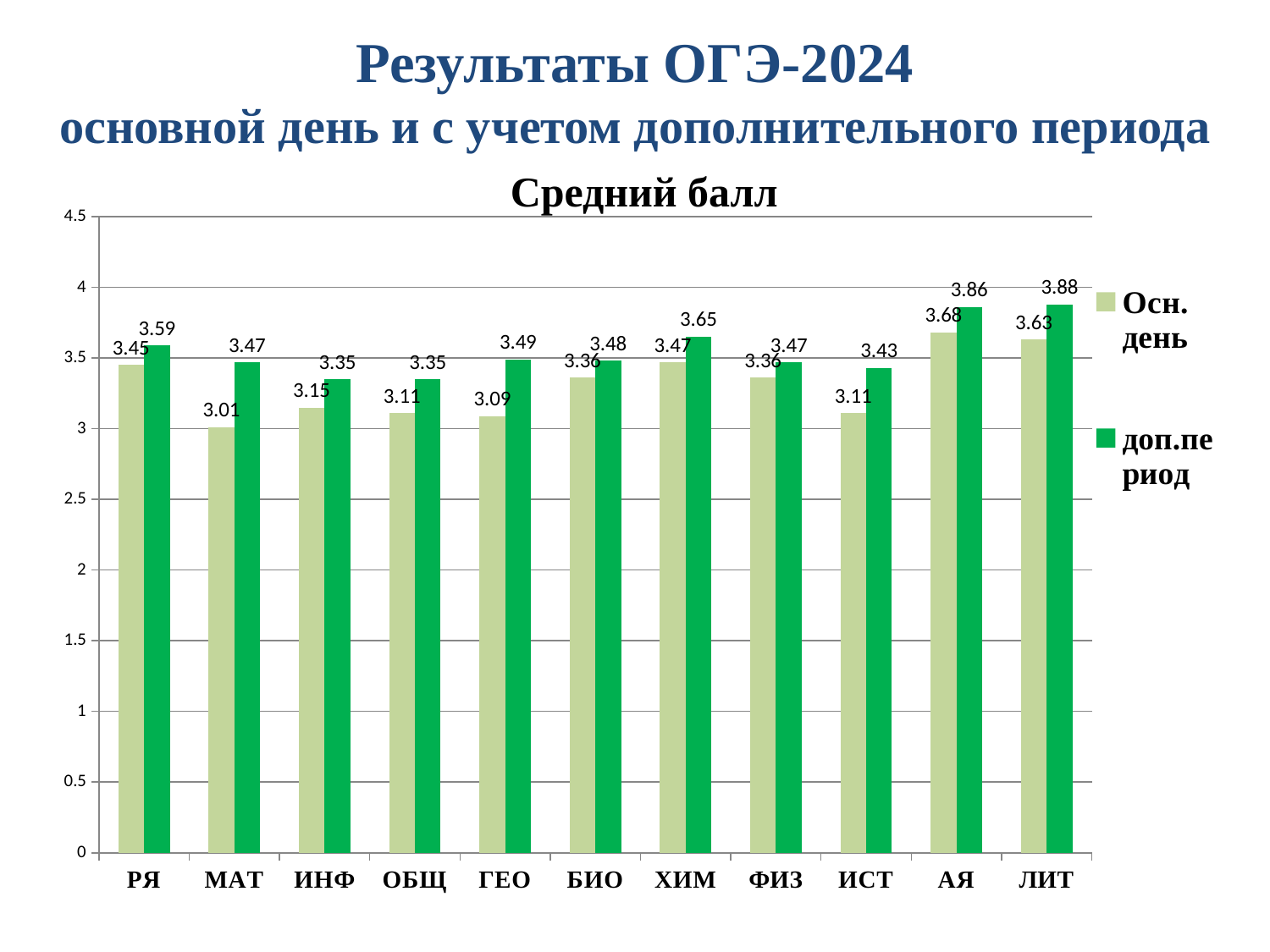
What is the difference between the доп.период and Осн. день values for МАТ? 0.46 Which is larger for ХИМ: the Осн. день value or the доп.период value? доп.период What kind of chart is shown on the slide? bar chart Which category has the lowest value in the Осн. день series? МАТ Which category has the highest value in the доп.период series? ЛИТ What is the value for ЛИТ in the доп.период series? 3.88 What is the value for ГЕО in the Осн. день series? 3.09 What is the value for МАТ in the Осн. день series? 3.01 How many series does the legend list? 2 How many categories are shown on the x axis? 11 Which category has the highest value in the Осн. день series? АЯ Is the Осн. день value for ИСТ greater or less than 3.5? less